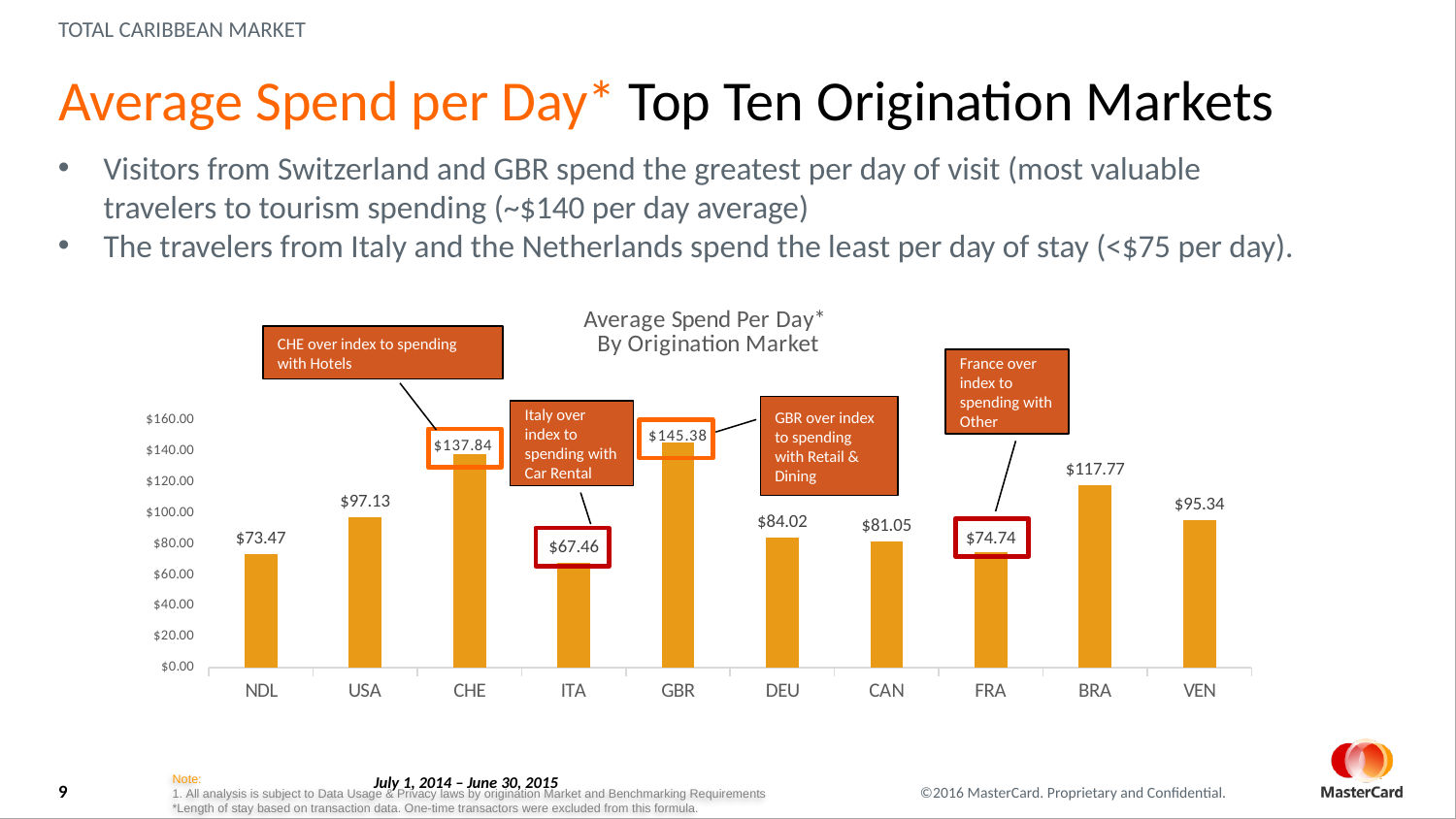
What is the title of the chart? Average Spend Per Day* By Origination Market Is the value for BRA greater or less than $100.00? greater Which has a higher average spend per day, USA or VEN? USA What is the average spend per day for CHE? $137.84 What is the difference in average spend per day between BRA and USA? $20.64 What type of chart is used to show average spend per day by origination market? Bar chart What is the average spend per day for BRA? $117.77 What is the average spend per day for DEU? $84.02 How many origination markets are shown in the chart? 10 Which origination market has the highest average spend per day? GBR Which origination market has the lowest average spend per day? ITA What is the difference in average spend per day between GBR and CHE? $7.54